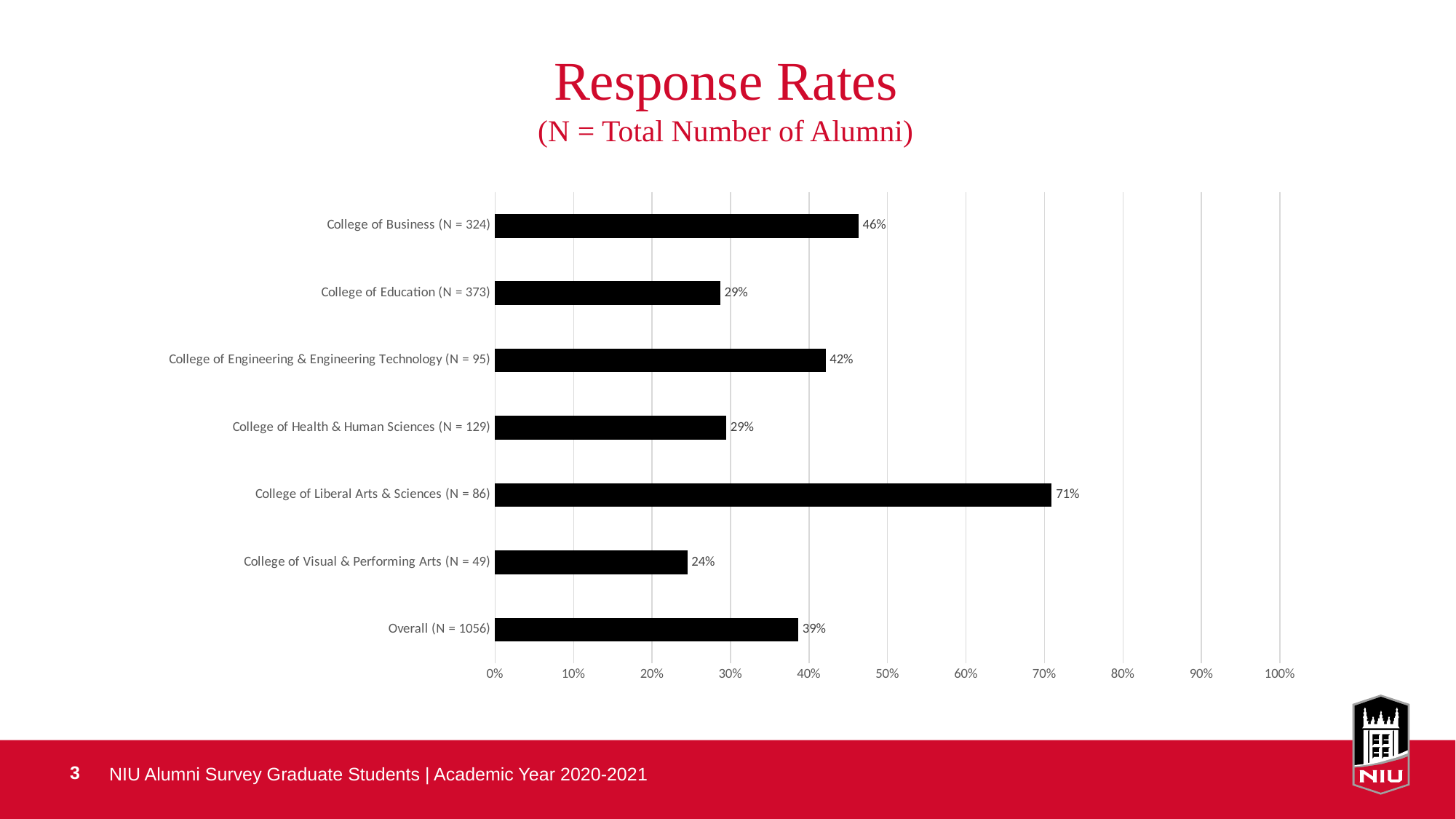
What is the difference between the response rates of the College of Liberal Arts & Sciences and the College of Business? 25% What is the Overall (N = 1056) response rate? 39% Which has a higher response rate, the College of Engineering & Engineering Technology or the College of Education? College of Engineering & Engineering Technology Which college has the lowest response rate? College of Visual & Performing Arts (N = 49) What is the response rate for the College of Business (N = 324)? 46% How many categories are shown in the chart? 7 What is the response rate for the College of Visual & Performing Arts (N = 49)? 24% What is the title of the chart on the slide? Response Rates (N = Total Number of Alumni) What is the response rate for the College of Liberal Arts & Sciences (N = 86)? 71% Which college has the highest response rate? College of Liberal Arts & Sciences (N = 86) What kind of chart is shown on the slide? bar chart Is the response rate for the College of Health & Human Sciences greater or less than 40%? less